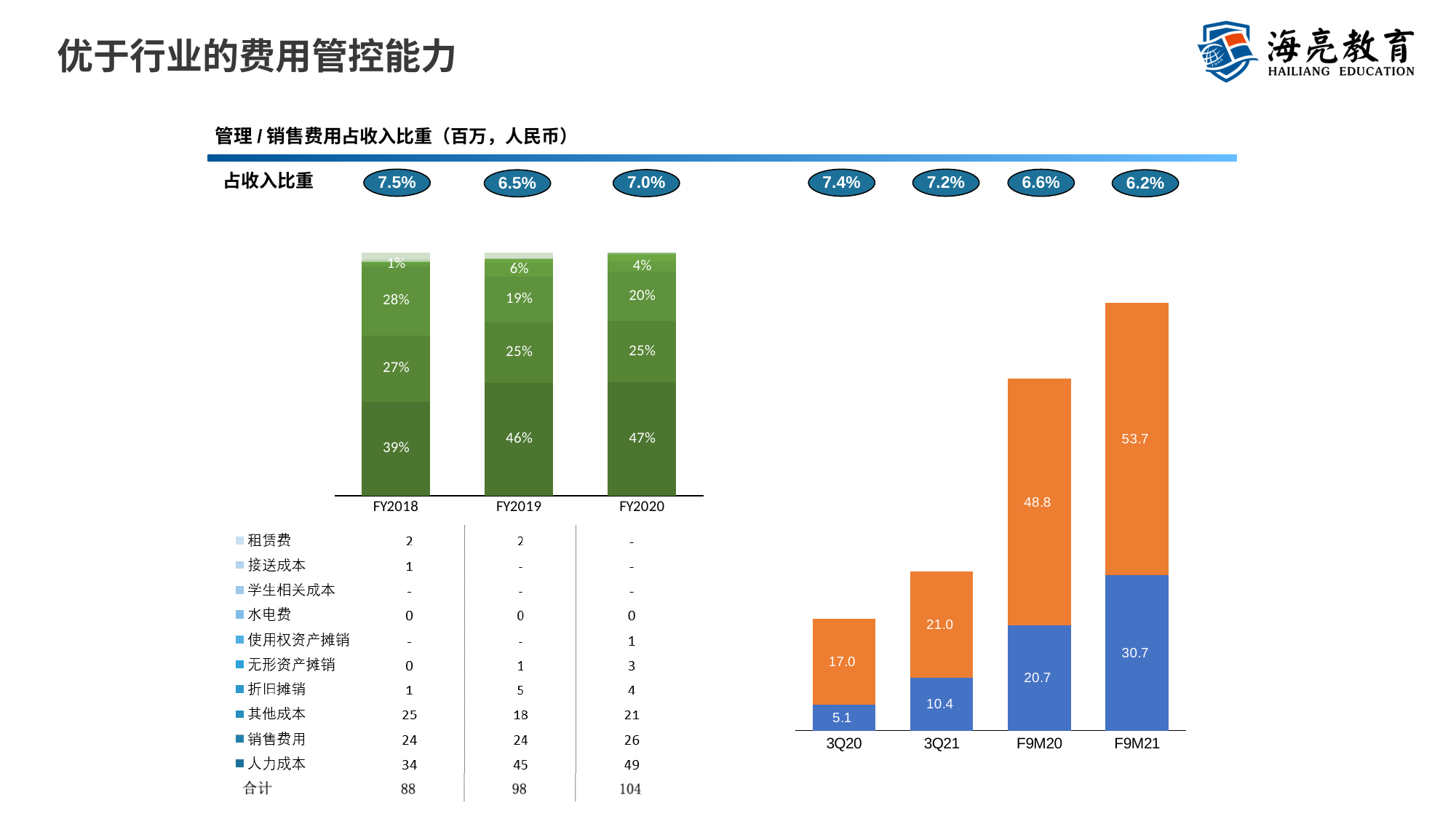
In the right chart, what is the value of the blue segment for 3Q20? 5.1 In the left chart, is the bottom segment for FY2018 larger or smaller than the bottom segment for FY2020? smaller In the right chart, does the blue segment rise or fall from 3Q20 to F9M21? rise In the left chart, what percentage does the bottom (darkest green) segment show for FY2019? 46% In the right chart, what is the value of the orange segment for F9M21? 53.7 In the right chart, which category has the tallest stacked bar? F9M21 In the right chart, what is the total of the stacked bar for F9M20? 69.5 In the right chart, how many categories are shown on the x axis? 4 In the right chart, what is the difference between the blue segments for 3Q21 and 3Q20? 5.3 In the left chart, what percentage does the top segment show for FY2020? 4% What kind of chart is the right chart? stacked bar chart In the left chart, which year has the largest bottom segment percentage? FY2020